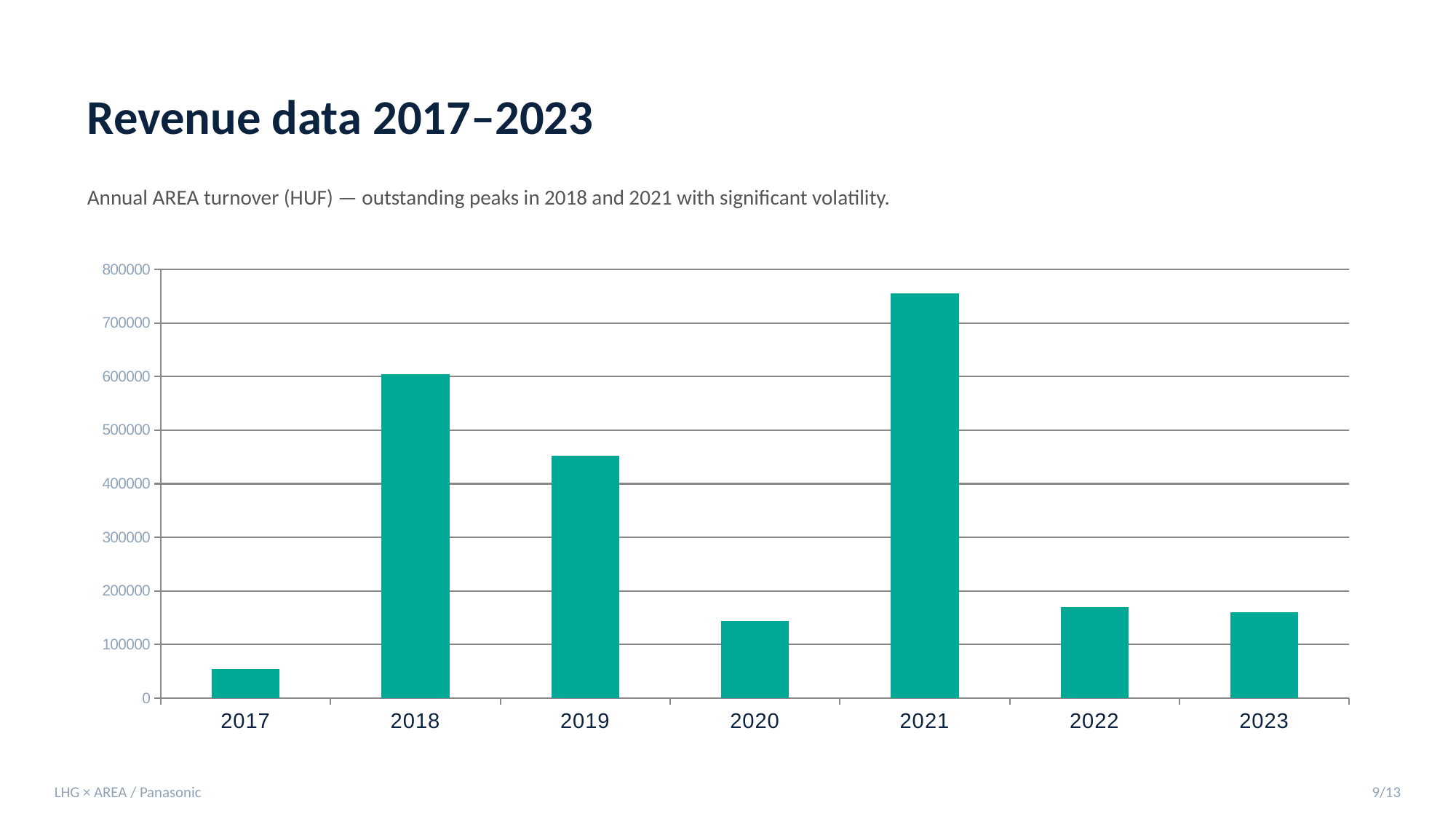
Which is larger, the revenue for 2020 or the revenue for 2022? 2022 Is the value for 2017 greater or less than 100000? less Is the value for 2021 greater or less than 700000? greater What is the title of the slide containing the chart? Revenue data 2017–2023 Which year has the lowest revenue in the chart? 2017 Is the value for 2019 greater or less than 500000? less What kind of chart is shown on the slide? bar chart Which year has the highest revenue in the chart? 2021 Which is larger, the revenue for 2018 or the revenue for 2019? 2018 How many years are shown on the x axis of the chart? 7